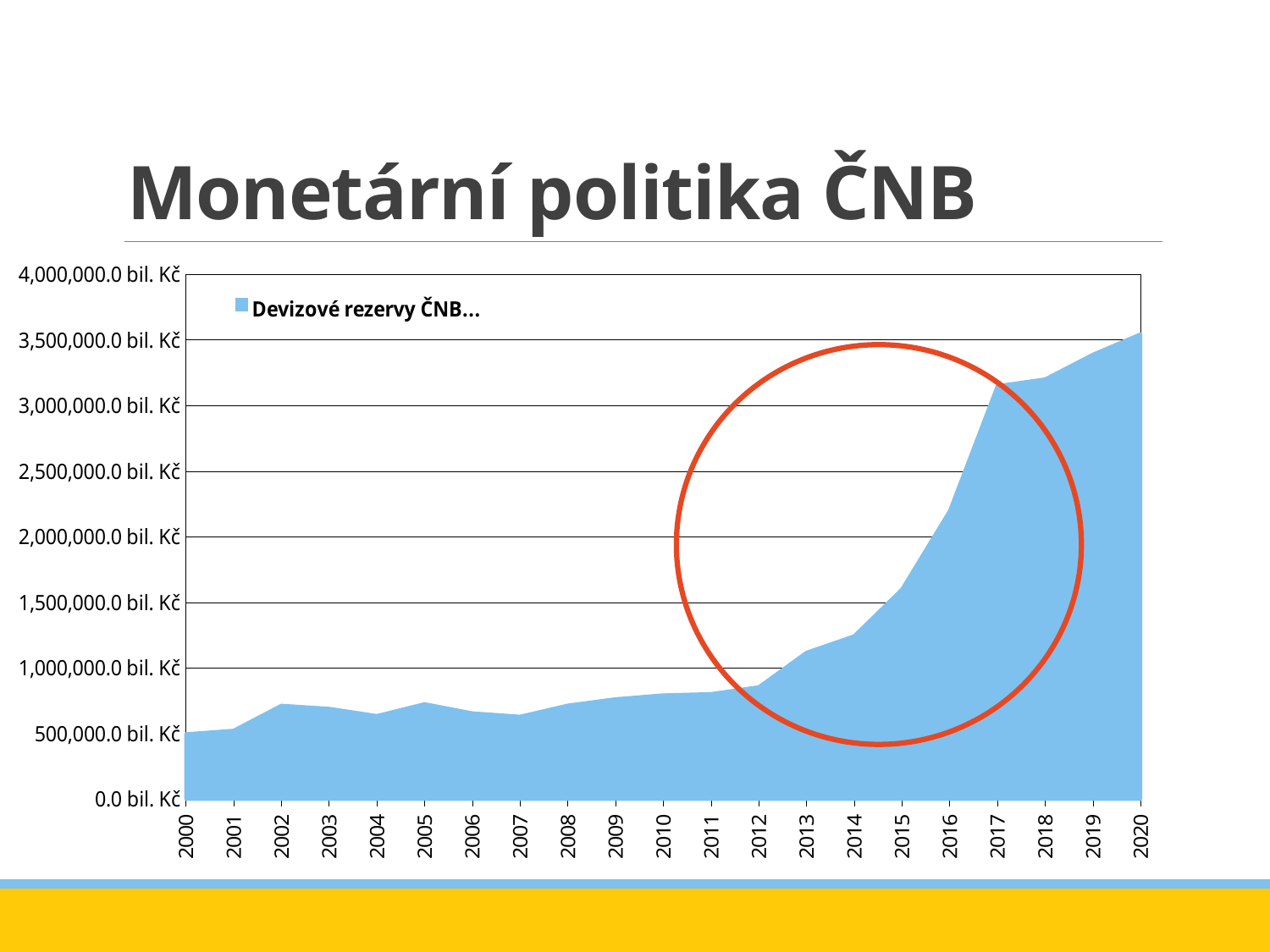
What kind of chart is shown on the slide? Area chart Is the value for 2014 greater or less than 1,000,000.0 bil. Kč? greater How many series does the legend list? 1 What is the name of the series shown in the legend? Devizové rezervy ČNB... Is the value for 2018 greater or less than 3,000,000.0 bil. Kč? greater How many years are plotted along the x axis? 21 Which year has the highest value? 2020 Do the values generally rise or fall from 2000 to 2020? Rise Is the value for 2016 greater or less than 2,500,000.0 bil. Kč? less Which year has the larger value, 2010 or 2020? 2020 Which year has the larger value, 2004 or 2005? 2005